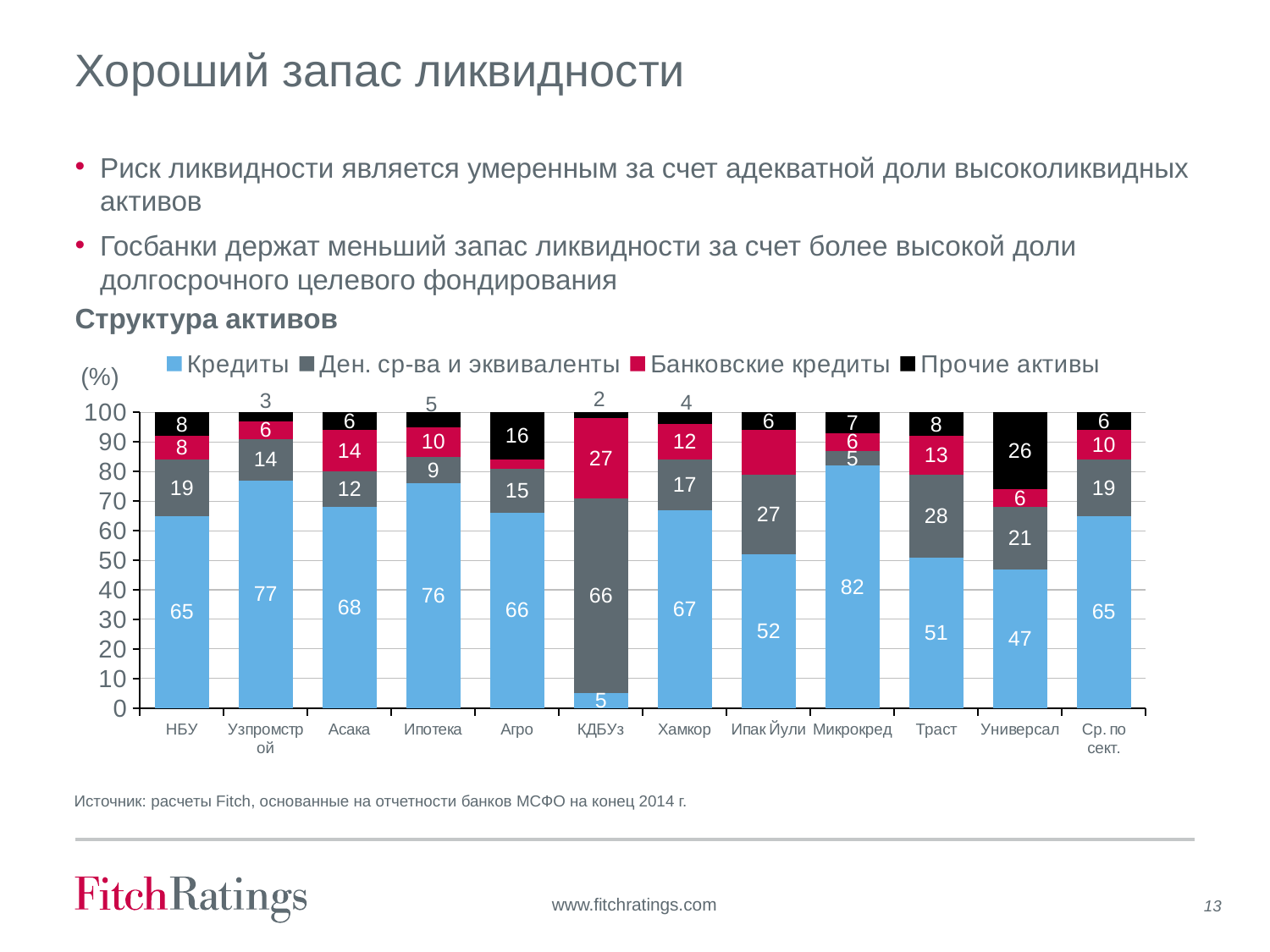
What is the value of Ден. ср-ва и эквиваленты for КДБУз? 66 What is the difference between the Кредиты values for Узпромстрой and Траст? 26 Which has a larger value for Ден. ср-ва и эквиваленты, Траст or Асака? Траст What kind of chart is shown on the slide? Stacked bar chart What is the value of Прочие активы for Универсал? 26 Which category has the highest value for Прочие активы? Универсал Which category has the highest value for Кредиты? Микрокред What is the value of Кредиты for Микрокред? 82 Which category has the lowest value for Кредиты? КДБУз What is the value of Банковские кредиты for Ср. по сект.? 10 How many series does the legend list? 4 How many categories are shown on the x axis? 12